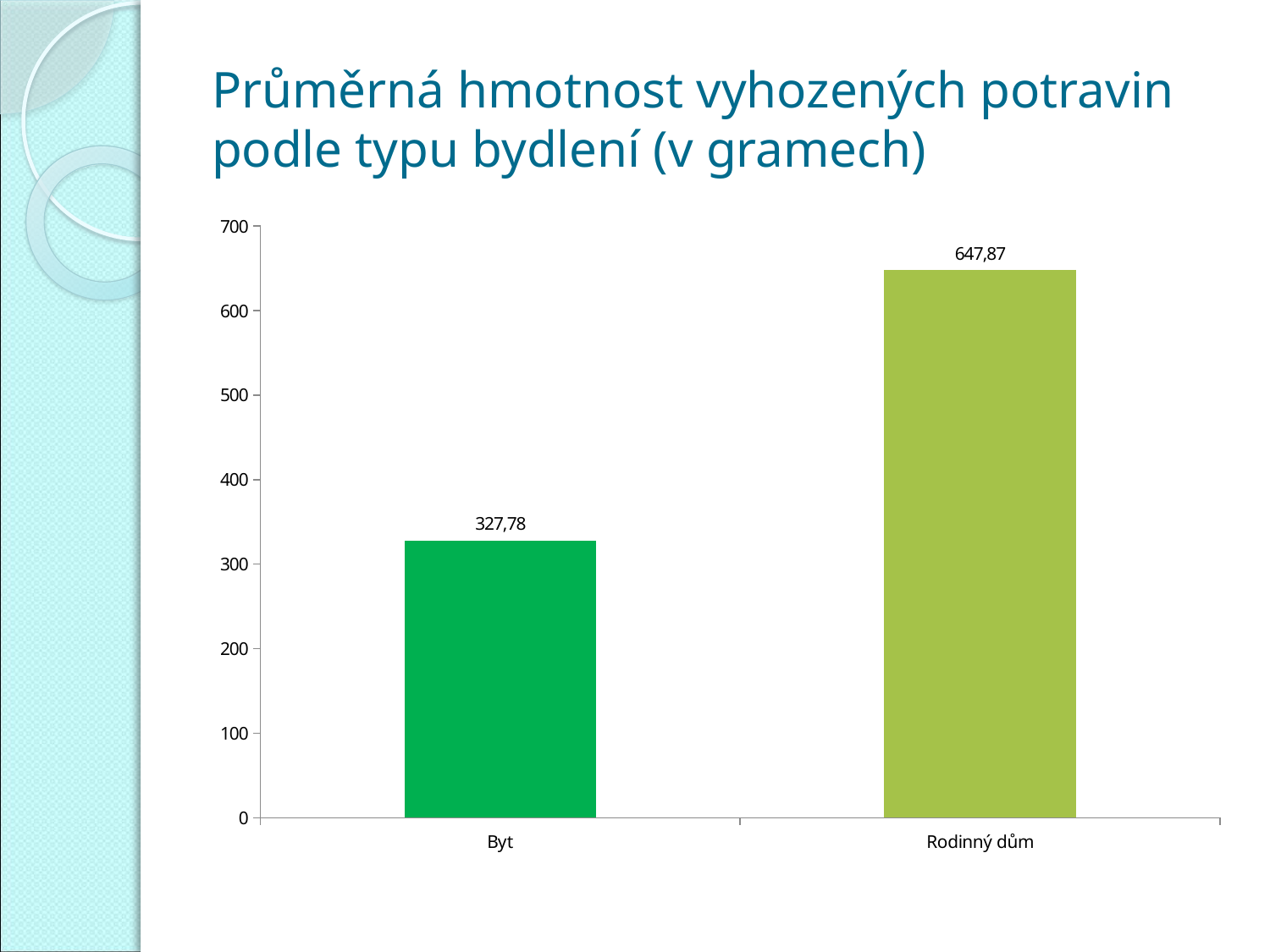
Is the value for Byt greater or less than 400? less What kind of chart is shown on the slide? bar chart What is the highest value shown on the vertical axis? 700 What is the title of the slide? Průměrná hmotnost vyhozených potravin podle typu bydlení (v gramech) Which category has the lowest value? Byt What is the value for Byt? 327,78 How many categories are shown in the chart? 2 Is the value for Rodinný dům greater or less than 600? greater Which is larger, the value for Byt or the value for Rodinný dům? Rodinný dům Which category has the highest value? Rodinný dům What is the value for Rodinný dům? 647,87 What is the difference between the values for Rodinný dům and Byt? 320,09